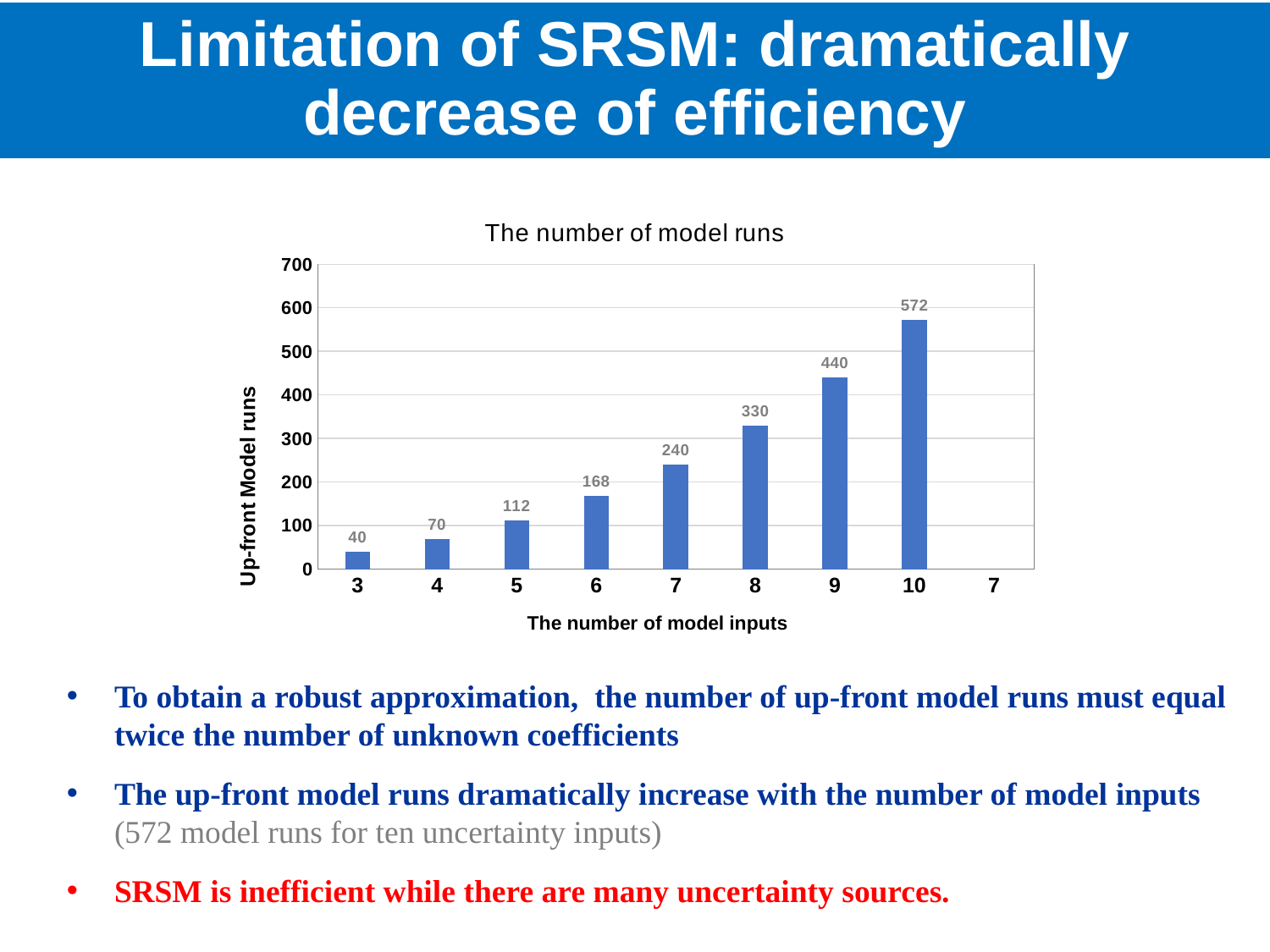
What kind of chart is shown on the slide? Bar chart Which number of model inputs has the lowest number of up-front model runs? 3 What is the number of up-front model runs for 10 model inputs? 572 Which has more up-front model runs: 4 model inputs or 6 model inputs? 6 model inputs How many bars are plotted in the chart? 8 Is the value for 9 model inputs greater or less than 400? greater What is the number of up-front model runs for 5 model inputs? 112 What is the difference in up-front model runs between 10 model inputs and 9 model inputs? 132 What is the difference in up-front model runs between 7 model inputs and 6 model inputs? 72 Which number of model inputs has the highest number of up-front model runs? 10 What is the number of up-front model runs for 8 model inputs? 330 Do the up-front model runs rise or fall as the number of model inputs increases from 3 to 10? Rise